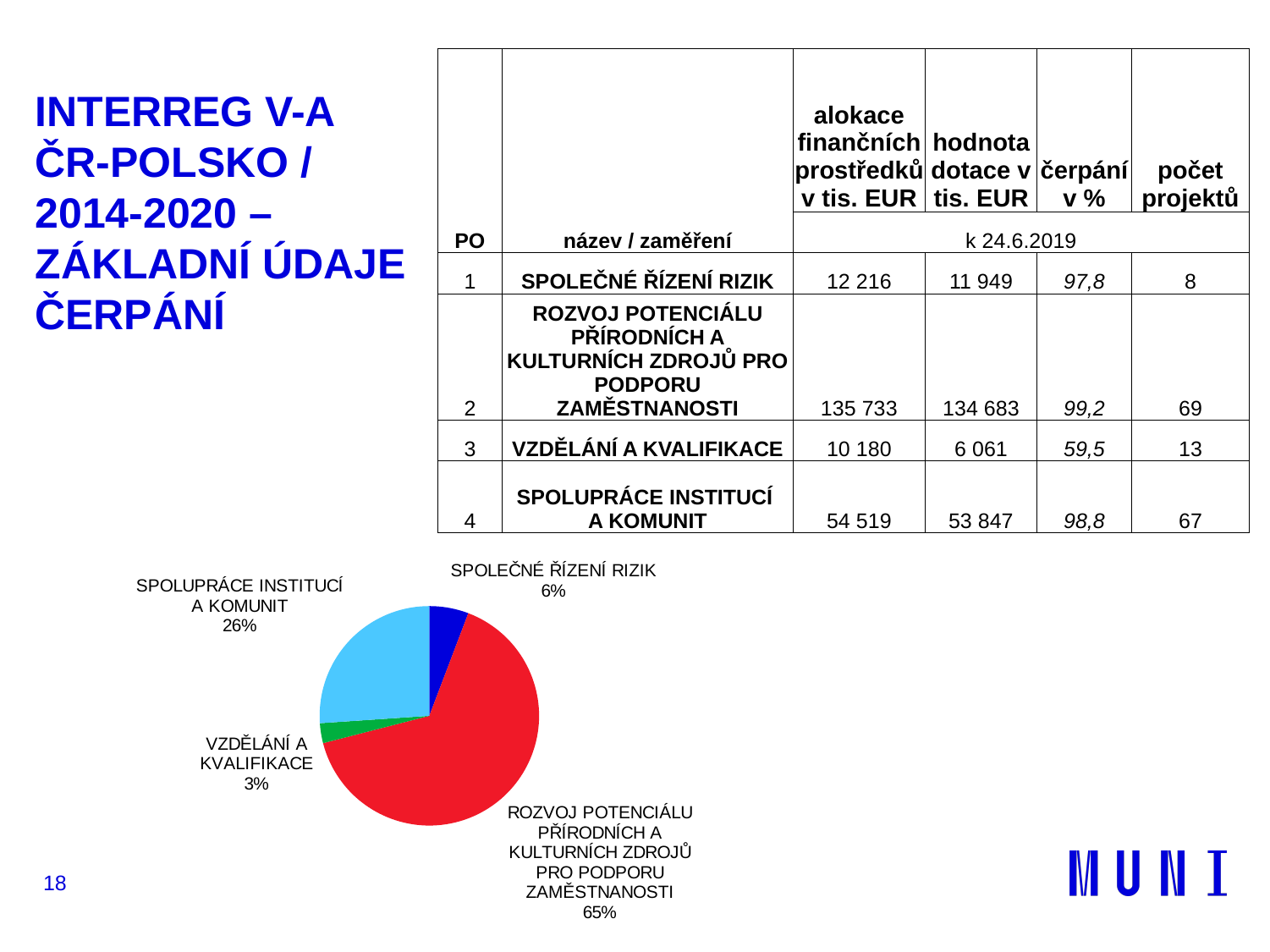
What share of the pie does SPOLEČNÉ ŘÍZENÍ RIZIK have? 6% Which slice is larger, SPOLEČNÉ ŘÍZENÍ RIZIK or VZDĚLÁNÍ A KVALIFIKACE? SPOLEČNÉ ŘÍZENÍ RIZIK What kind of chart is shown on the slide? pie chart What colour is the SPOLUPRÁCE INSTITUCÍ A KOMUNIT slice? light blue Which slice of the pie chart is the smallest? VZDĚLÁNÍ A KVALIFIKACE What share of the pie does ROZVOJ POTENCIÁLU PŘÍRODNÍCH A KULTURNÍCH ZDROJŮ PRO PODPORU ZAMĚSTNANOSTI have? 65% Which slice of the pie chart is the largest? ROZVOJ POTENCIÁLU PŘÍRODNÍCH A KULTURNÍCH ZDROJŮ PRO PODPORU ZAMĚSTNANOSTI What is the difference in percentage points between the SPOLUPRÁCE INSTITUCÍ A KOMUNIT slice and the SPOLEČNÉ ŘÍZENÍ RIZIK slice? 20 How many slices does the pie chart have? 4 What share of the pie does VZDĚLÁNÍ A KVALIFIKACE have? 3% What colour is the largest slice of the pie chart? red